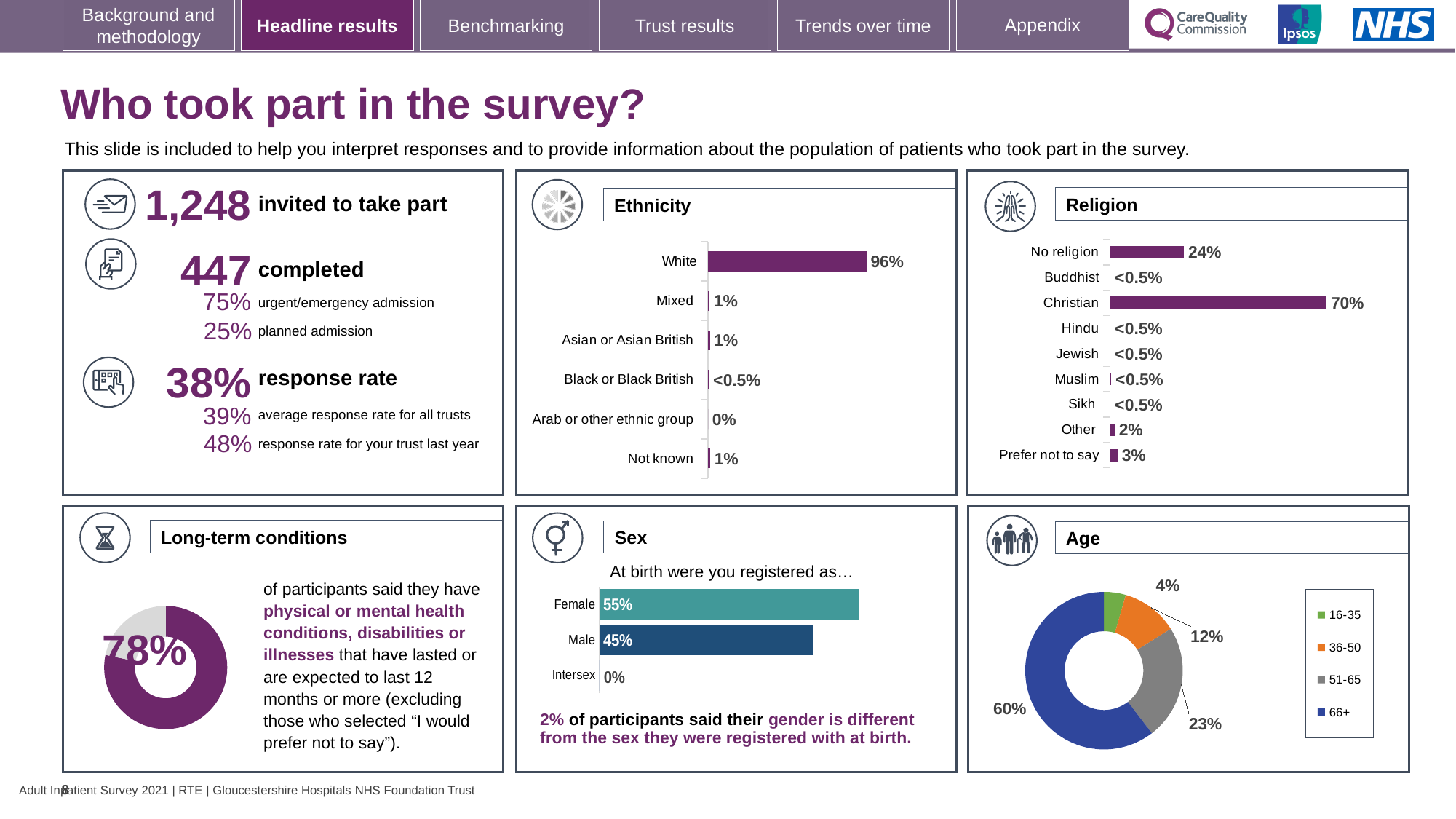
What kind of chart is used in the Age panel? Donut chart In the Religion chart, what percentage of participants were Christian? 70% How many age groups does the legend of the Age chart list? 4 In the Religion chart, which is larger, Other or Prefer not to say? Prefer not to say In the Religion chart, what is the difference between the Christian and No religion values? 46 percentage points In the Ethnicity chart, what percentage of participants were White? 96% How many ethnic categories are shown in the Ethnicity chart? 6 In the Ethnicity chart, what is the value for Arab or other ethnic group? 0% In the Sex chart, what percentage of participants were registered as Female at birth? 55% In the Age chart, what share of participants were aged 66+? 60% In the Sex chart, what is the difference between the Female and Male values? 10 percentage points In the Ethnicity chart, which ethnic group has the highest value? White